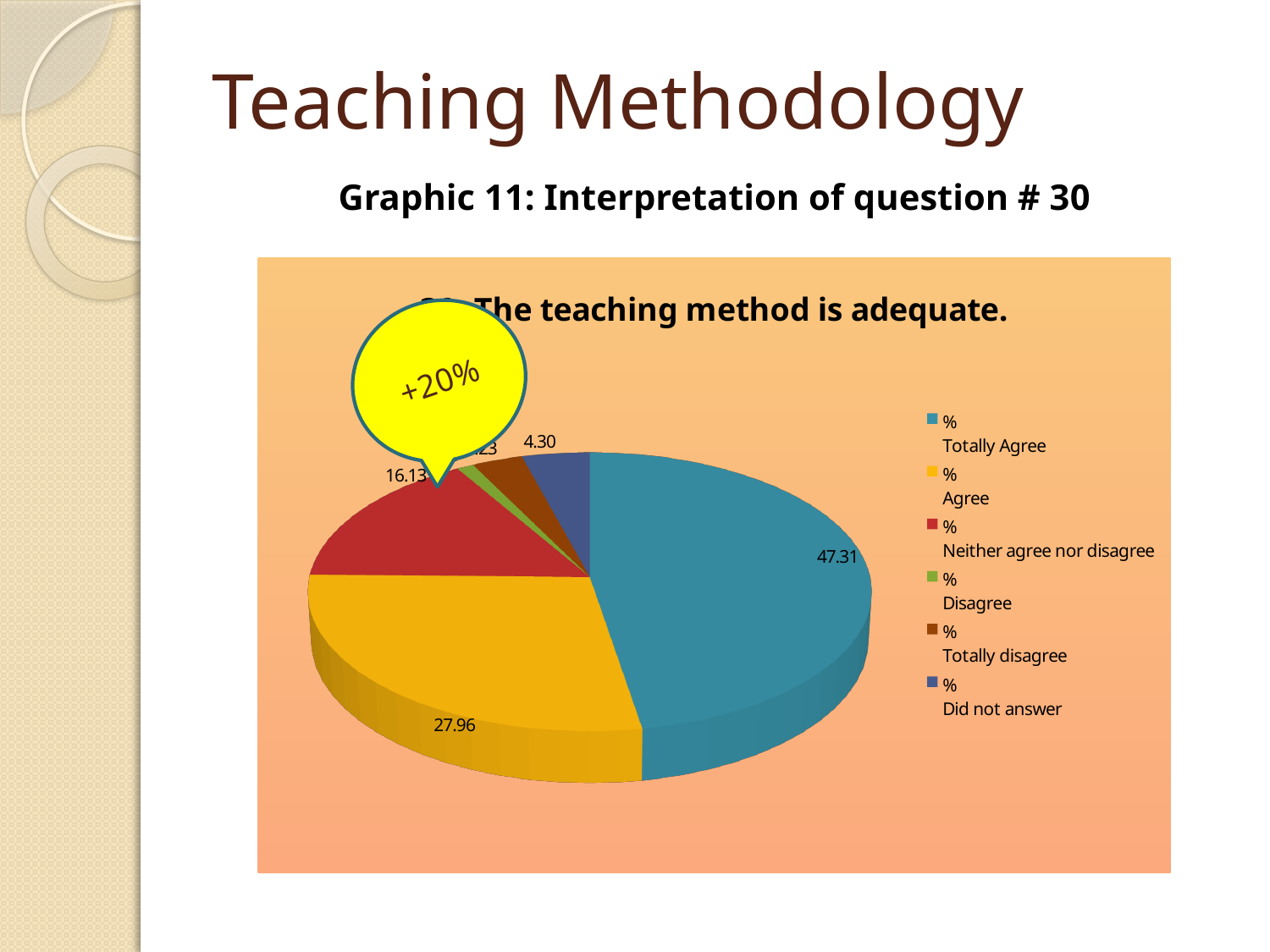
What kind of chart is shown on the slide? Pie chart Which category has the smallest slice of the pie chart? Disagree What value is shown for Neither agree nor disagree in the pie chart? 16.13 What colour is the Agree slice in the pie chart? Yellow What value is shown for Totally Agree in the pie chart? 47.31 What value is shown for Did not answer in the pie chart? 4.30 What is the difference between the values for Totally Agree and Agree? 19.35 What is the caption above the chart on the slide? Graphic 11: Interpretation of question # 30 Which category has the largest slice of the pie chart? Totally Agree How many categories does the pie chart show? 6 What value is shown for Agree in the pie chart? 27.96 Which is larger, the value for Totally Agree or the value for Agree? Totally Agree